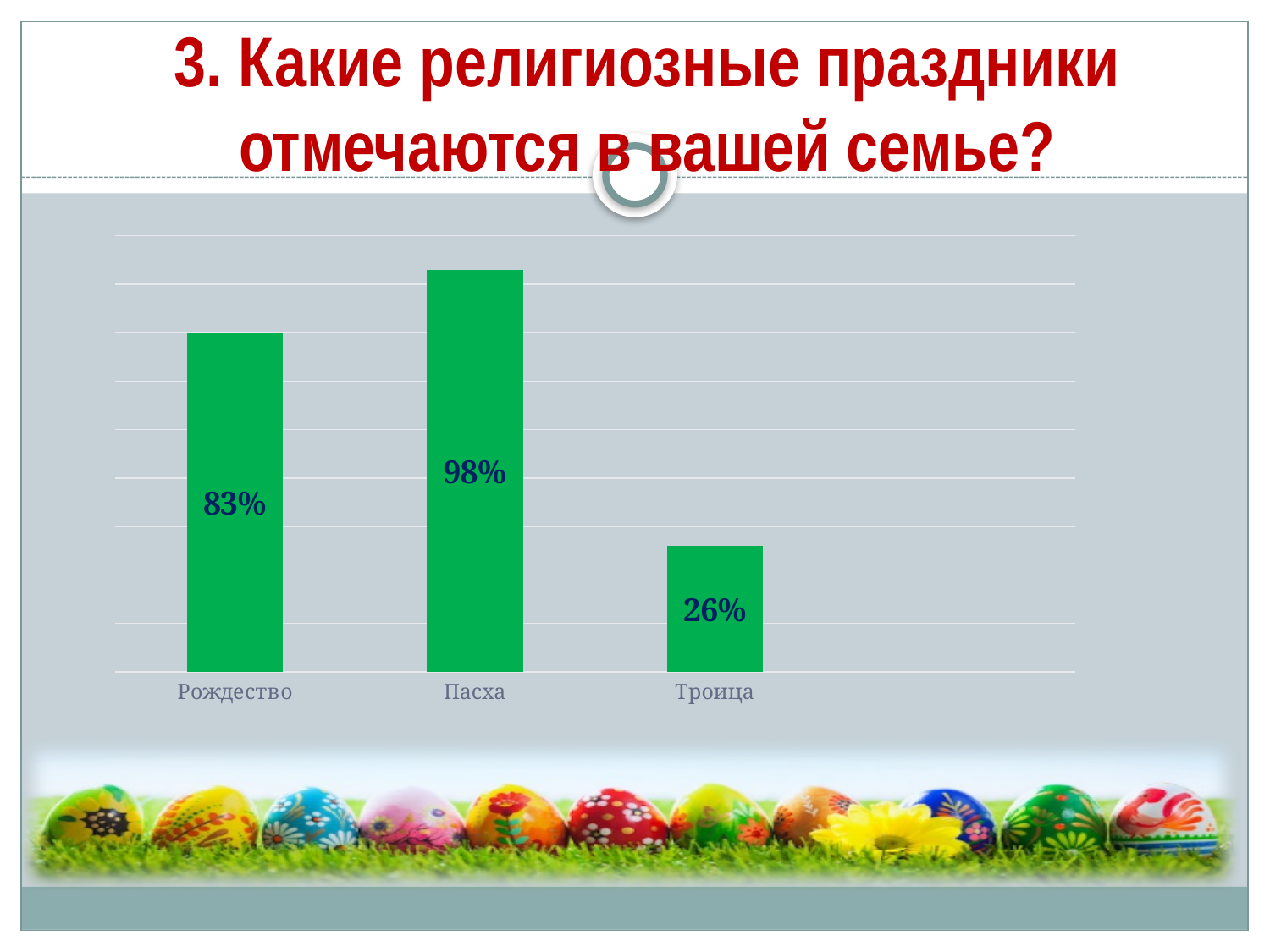
What is the value for Рождество? 83% How many categories are shown in the chart? 3 What is the difference between the values for Рождество and Троица? 57% What is the title of the slide above the chart? 3. Какие религиозные праздники отмечаются в вашей семье? What is the value for Пасха? 98% Which category has the lowest value? Троица Which category has the highest value? Пасха Which is larger, the value for Рождество or the value for Троица? Рождество What kind of chart is shown on the slide? bar chart What is the difference between the values for Пасха and Рождество? 15% What colour are the bars in the chart? green What is the value for Троица? 26%